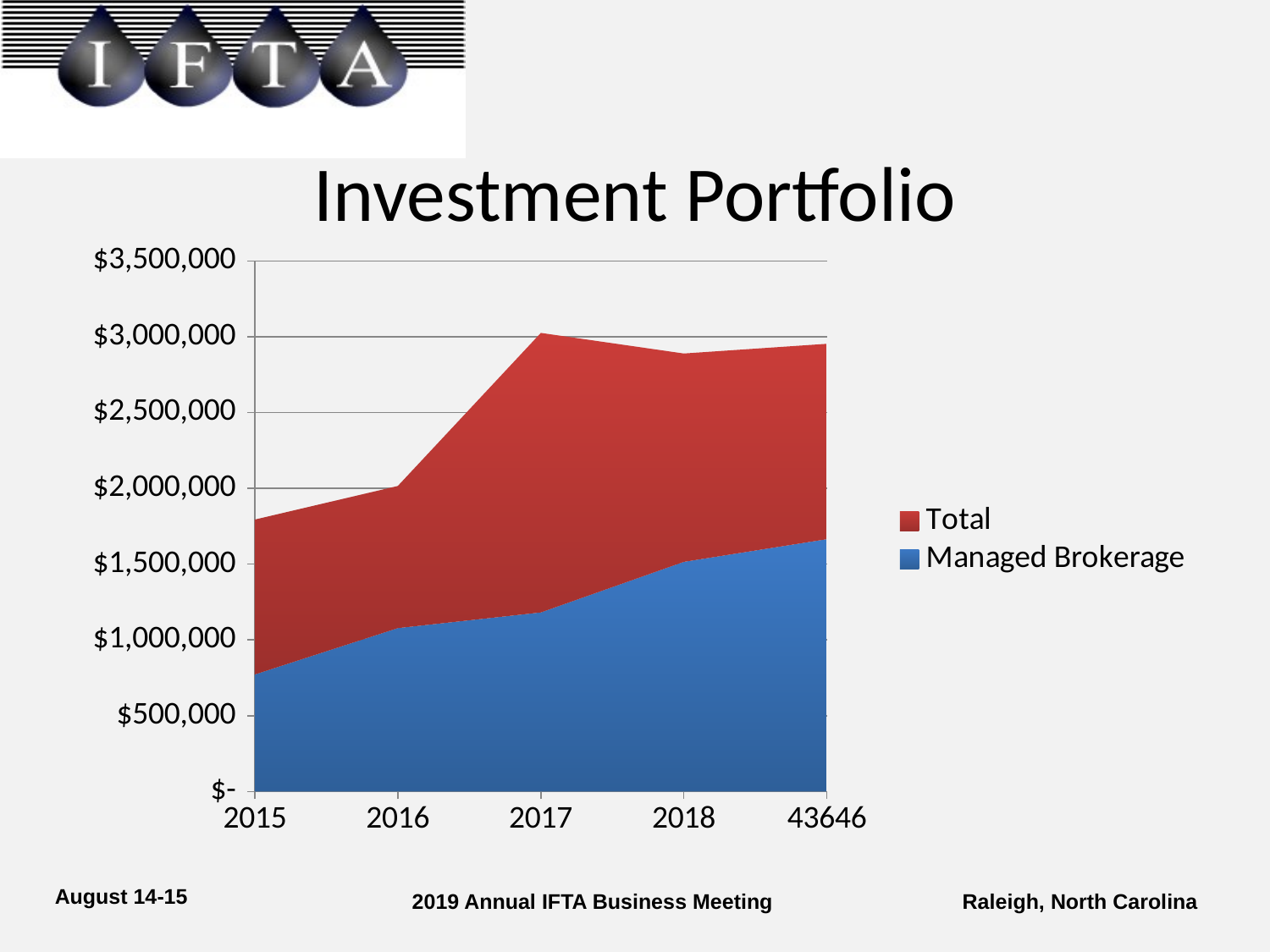
Which series are listed in the legend? Total and Managed Brokerage Does the Managed Brokerage series rise or fall from 2015 to 43646? Rise How many points are plotted along the x axis? 5 Is the Managed Brokerage value for 2015 greater or less than $1,000,000? less At which x-axis point is the Managed Brokerage value highest? 43646 Is the Managed Brokerage value for 43646 greater or less than $1,500,000? greater Is the Total value for 2015 greater or less than $2,000,000? less How many series does the legend list? 2 What kind of chart is shown on the slide? Area chart What is the title of the chart? Investment Portfolio